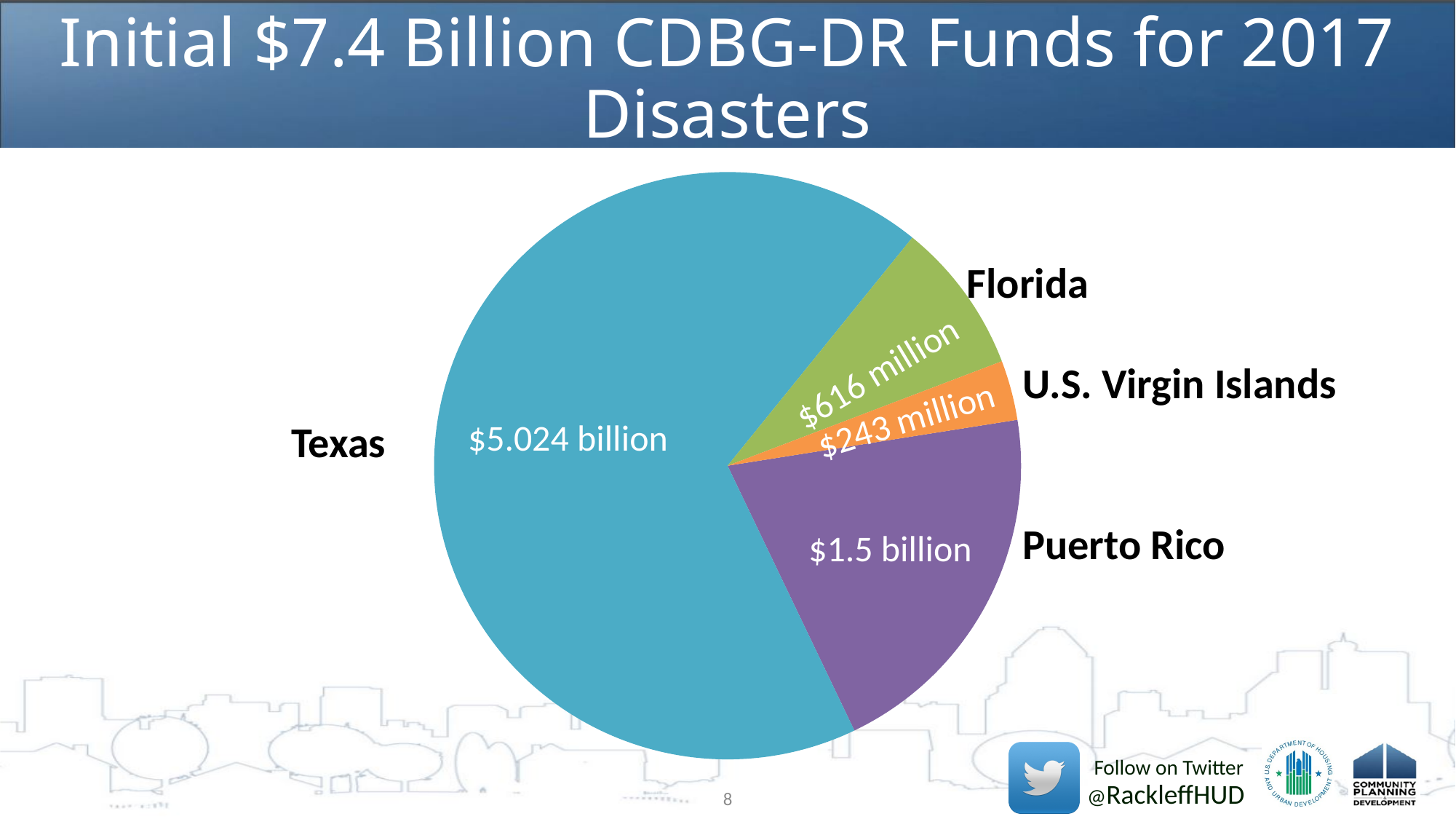
How much more funding did Texas receive than Puerto Rico? $3.524 billion How much more funding did Florida receive than the U.S. Virgin Islands? $373 million Which received more funding, Puerto Rico or Florida? Puerto Rico What kind of chart is shown on the slide? Pie chart How much CDBG-DR funding is shown for the U.S. Virgin Islands? $243 million How much CDBG-DR funding is shown for Texas? $5.024 billion Which area received the largest share of the initial CDBG-DR funds? Texas What is the title of the slide containing the pie chart? Initial $7.4 Billion CDBG-DR Funds for 2017 Disasters How much CDBG-DR funding is shown for Puerto Rico? $1.5 billion Which area received the smallest share of the initial CDBG-DR funds? U.S. Virgin Islands How much CDBG-DR funding is shown for Florida? $616 million How many areas (slices) are shown in the pie chart? 4